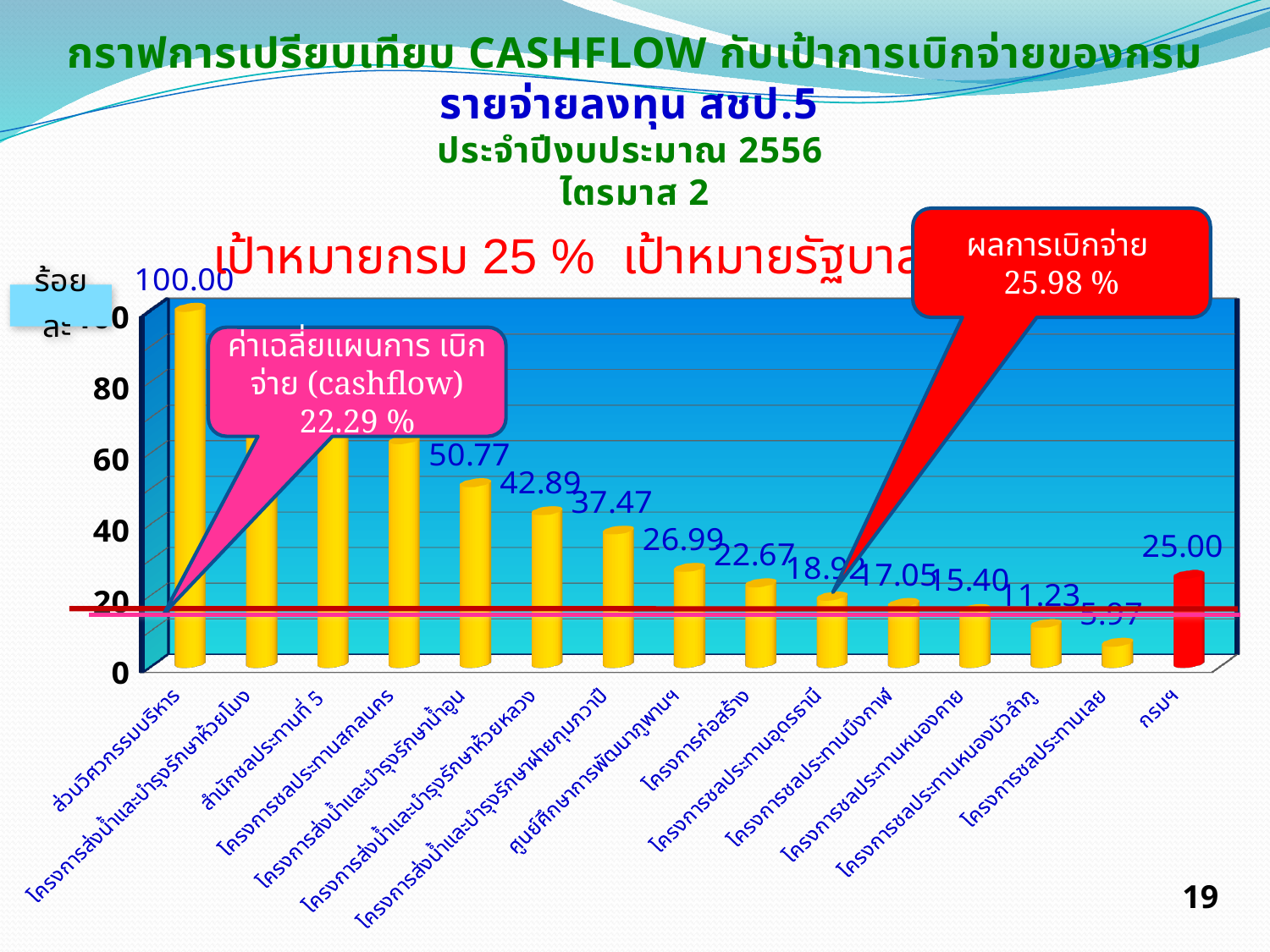
What is the value for ส่วนวิศวกรรมบริหาร? 100.00 What is the value shown for the red bar กรมฯ? 25.00 Which category has the highest value? ส่วนวิศวกรรมบริหาร How many categories are shown on the x axis? 15 What is the value for โครงการชลประทานเลย? 5.97 What is the value for โครงการส่งน้ำและบำรุงรักษาน้ำอูน? 50.77 Which category has the lowest value? โครงการชลประทานเลย Is the value for สำนักชลประทานที่ 5 greater or less than 40? greater What kind of chart is shown on the slide? bar chart What percentage does the red callout ผลการเบิกจ่าย show? 25.98 % Which is larger, the value for โครงการชลประทานหนองคาย or โครงการชลประทานหนองบัวลำภู? โครงการชลประทานหนองคาย What is the difference between the values for โครงการส่งน้ำและบำรุงรักษาห้วยหลวง and โครงการส่งน้ำและบำรุงรักษาฝายกุมภวาปี? 5.42